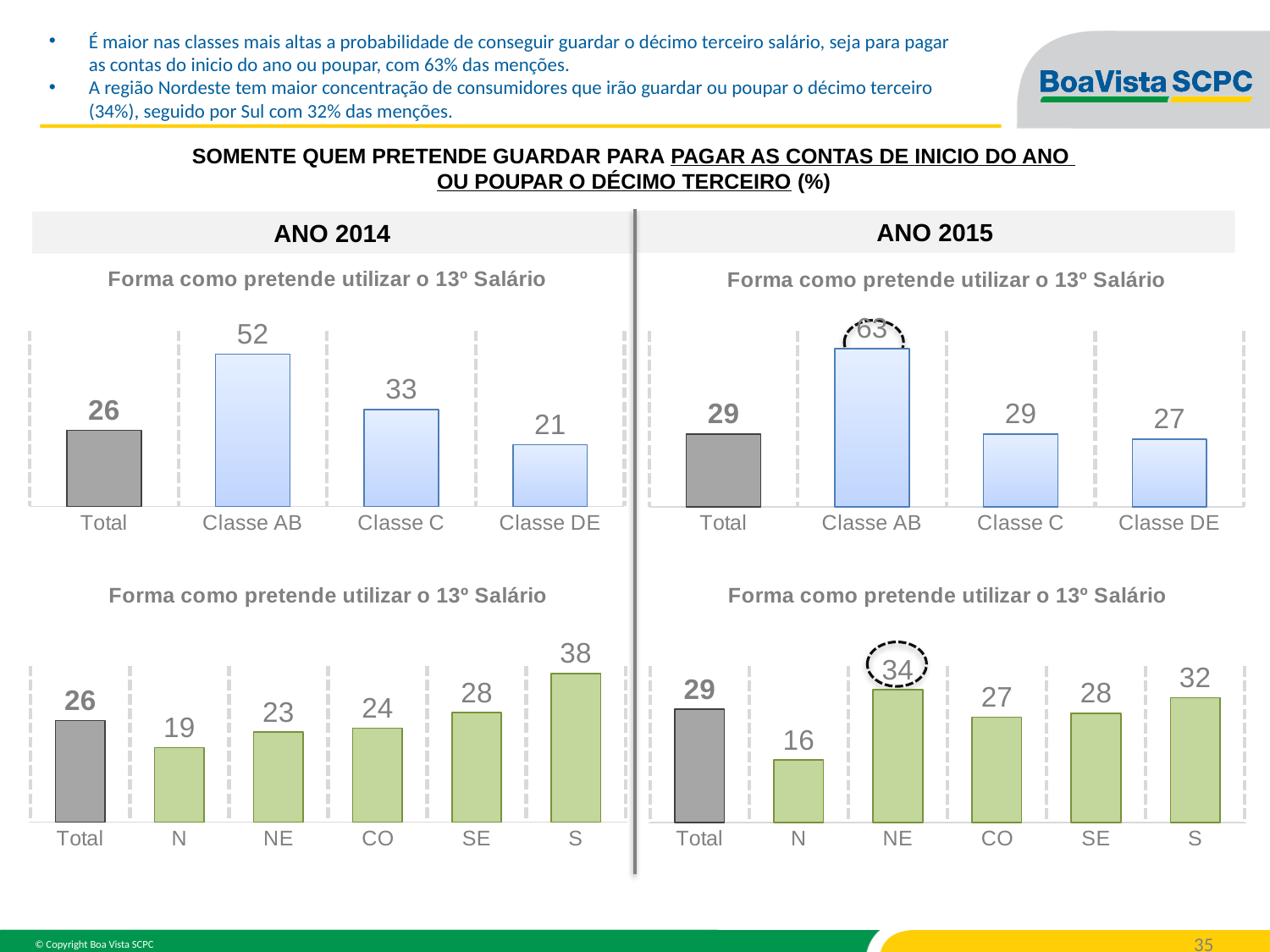
In the top-left chart (ANO 2014, by class), which category has the lowest value? Classe DE What type of chart is the top-left chart (ANO 2014, by class)? Bar chart How many categories are shown in the bottom-left chart (ANO 2014, by region)? 6 In the top-left chart (ANO 2014, by class), what is the value for Classe AB? 52 In the bottom-right chart (ANO 2015, by region), what is the value for NE? 34 In the top-right chart (ANO 2015, by class), what is the value for Classe AB? 63 In the bottom-left chart (ANO 2014, by region), which region has the highest value? S In the bottom-right chart (ANO 2015, by region), which region has the lowest value? N In the bottom-right chart (ANO 2015, by region), which is larger, the value for NE or the value for S? NE What is the title of the top-right chart (ANO 2015, by class)? Forma como pretende utilizar o 13º Salário In the top-right chart (ANO 2015, by class), what is the difference between Classe AB and Classe DE? 36 In the bottom-left chart (ANO 2014, by region), what is the difference between S and N? 19